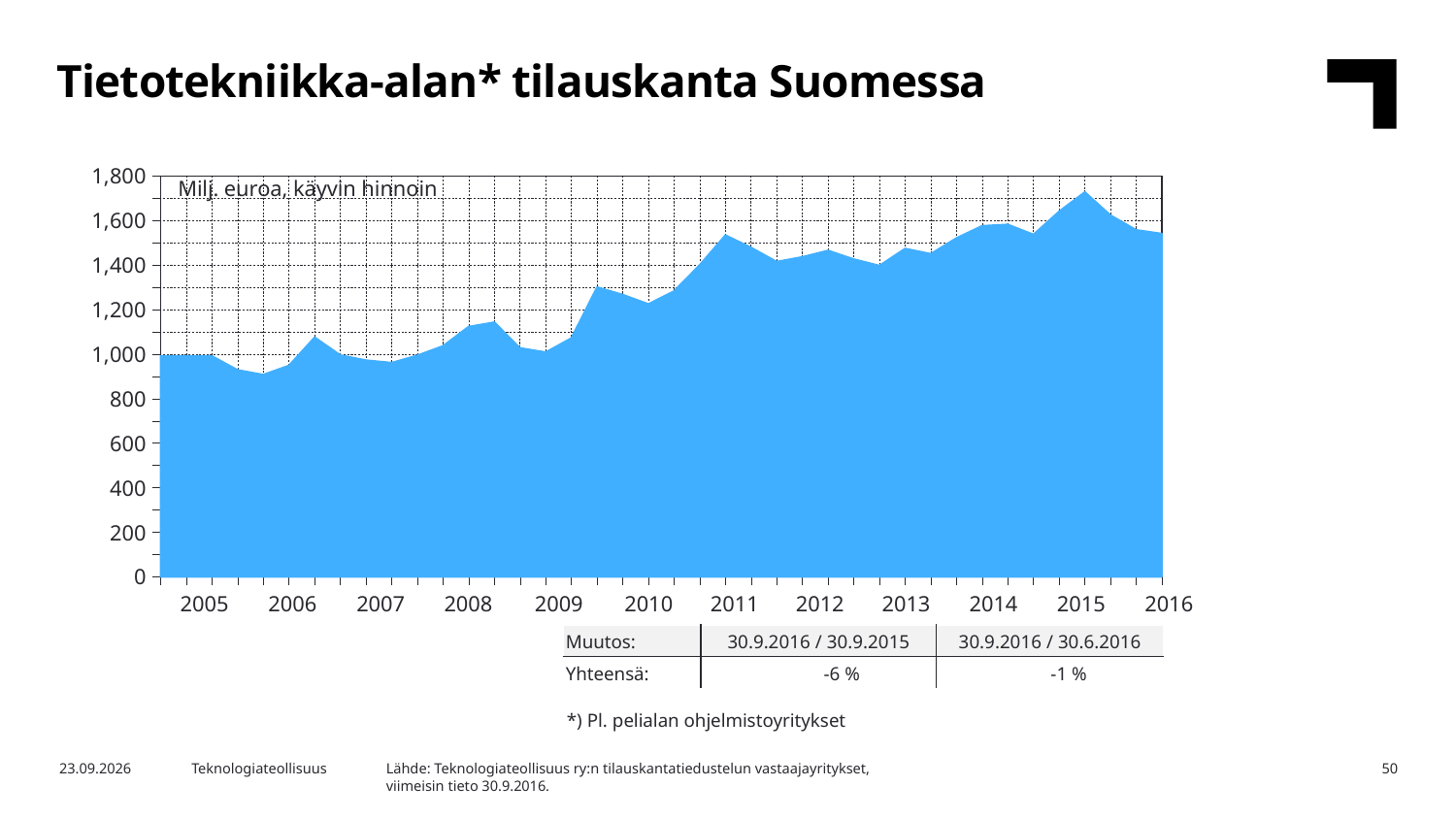
Is the value around 2007 greater or less than 1,200? less What unit is stated inside the chart area? Milj. euroa, käyvin hinnoin According to the table below the chart, what is the change (Muutos) for 30.9.2016 / 30.9.2015? -6 % Overall, does the order book value rise or fall from 2005 to 2016? Rise In which year does the series reach its highest point? 2015 Is the highest value of the series, reached around 2015, greater or less than 1,600? greater How many years are labelled on the x axis? 12 Is the value at the end of the series in 2016 greater or less than 1,400? greater What kind of chart is shown on the slide? Area chart What is the title of the chart? Tietotekniikka-alan* tilauskanta Suomessa